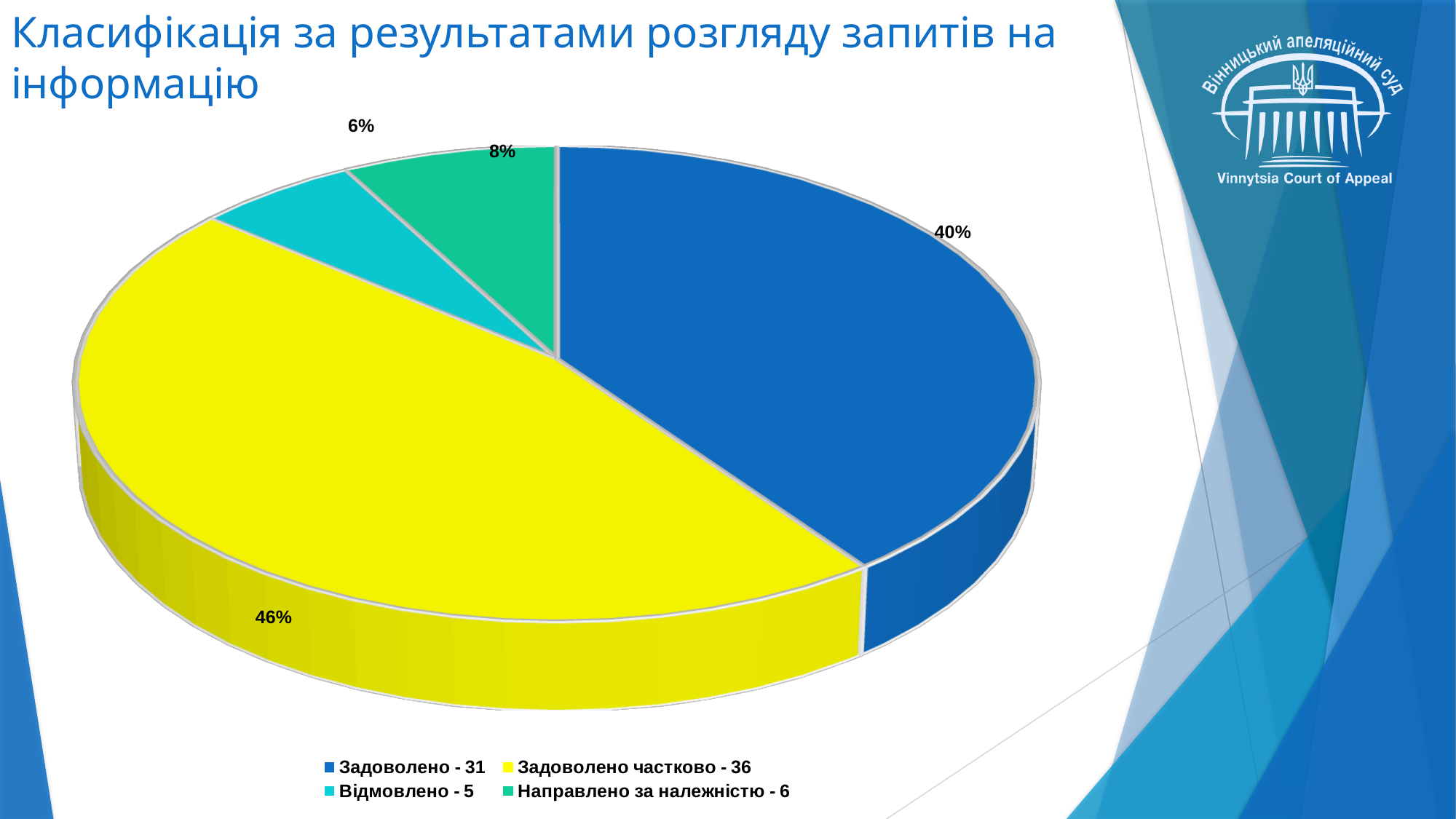
How many slices does the pie chart have? 4 What percentage share does the slice "Направлено за належністю - 6" have? 8% What percentage share does the slice "Задоволено частково - 36" have? 46% What percentage share does the slice "Задоволено - 31" have? 40% What is the difference in percentage points between the "Задоволено частково - 36" slice and the "Задоволено - 31" slice? 6% What colour is the "Задоволено частково - 36" slice? yellow Which category has the largest slice of the pie? Задоволено частково - 36 Which category has the smallest slice of the pie? Відмовлено - 5 How many entries does the legend list? 4 Which slice is larger: "Направлено за належністю - 6" or "Відмовлено - 5"? Направлено за належністю - 6 What kind of chart is shown on the slide? pie chart